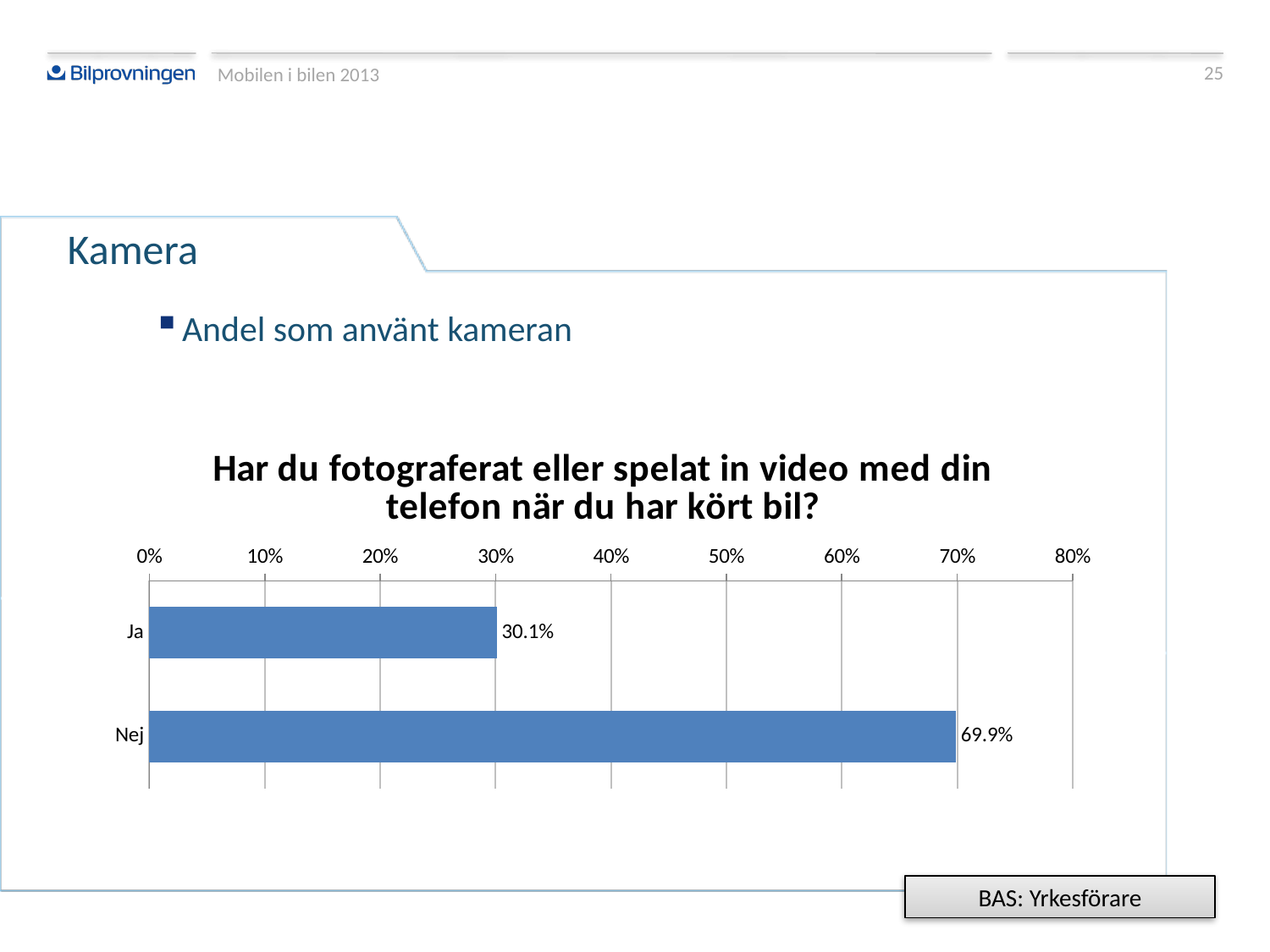
Which is larger, the value for "Ja" or the value for "Nej"? Nej What is the highest value shown on the x axis? 80% Which category has the lowest value? Ja What kind of chart is shown on the slide? bar chart Is the value for "Nej" greater or less than 60%? greater Which category has the highest value? Nej How many categories are shown in the chart? 2 What is the value for "Nej"? 69.9% What is the difference between the values for "Nej" and "Ja"? 39.8% What is the title of the chart? Har du fotograferat eller spelat in video med din telefon när du har kört bil? What is the value for "Ja"? 30.1% Is the value for "Ja" greater or less than 40%? less